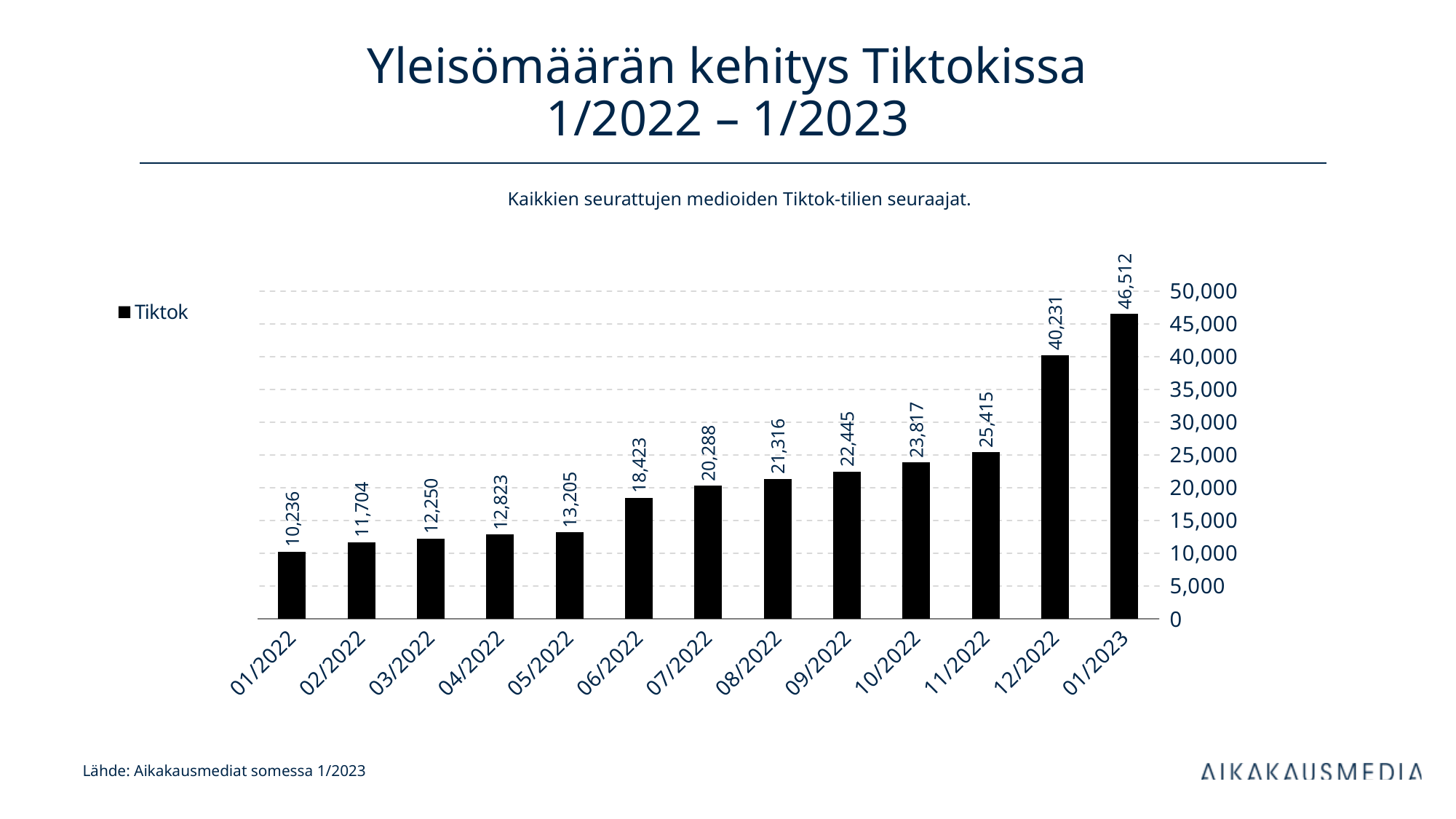
What is the difference between the values for 01/2023 and 12/2022? 6,281 What is the value for 12/2022? 40,231 Do the values rise or fall from 01/2022 to 01/2023? rise Is the value for 11/2022 greater or less than 30,000? less How many series does the legend list? 1 Which month has the lowest value? 01/2022 Which is larger, the value for 09/2022 or the value for 08/2022? 09/2022 What kind of chart is shown? bar chart How many months are shown on the x axis? 13 Which month has the highest value? 01/2023 What is the value for 01/2022? 10,236 What is the value for 06/2022? 18,423